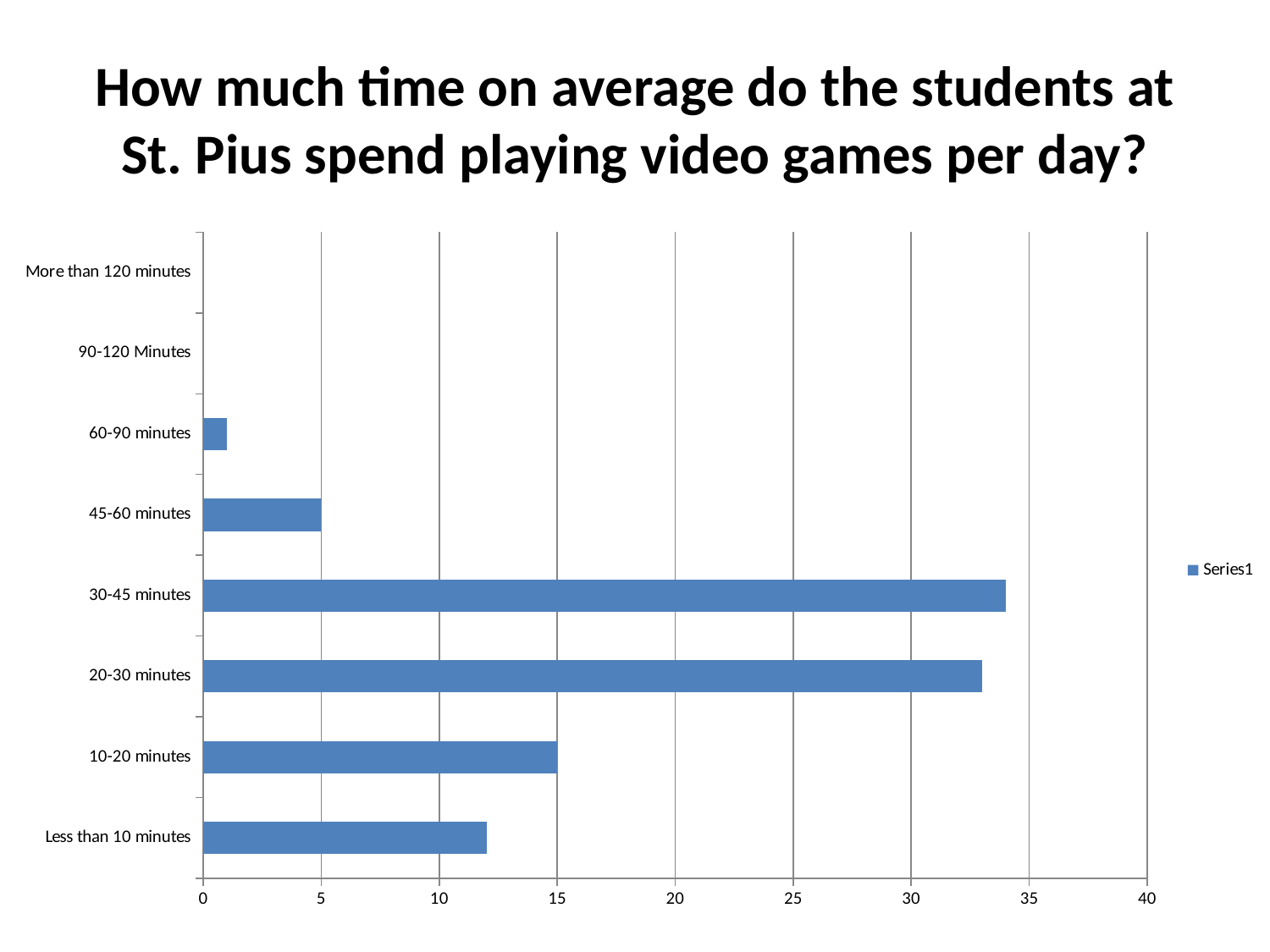
Which is larger, the value for 10-20 minutes or the value for Less than 10 minutes? 10-20 minutes Is the value for 20-30 minutes greater or less than 30? greater What is the value for 10-20 minutes? 15 Is the value for 60-90 minutes greater or less than 5? less Which category has the highest value? 30-45 minutes What is the difference between the value for 10-20 minutes and the value for 45-60 minutes? 10 What is the name of the series shown in the legend? Series1 What type of chart is shown on the slide? bar chart How many categories are shown on the chart? 8 How many series does the legend list? 1 What is the value for 45-60 minutes? 5 Is the value for Less than 10 minutes greater or less than 10? greater